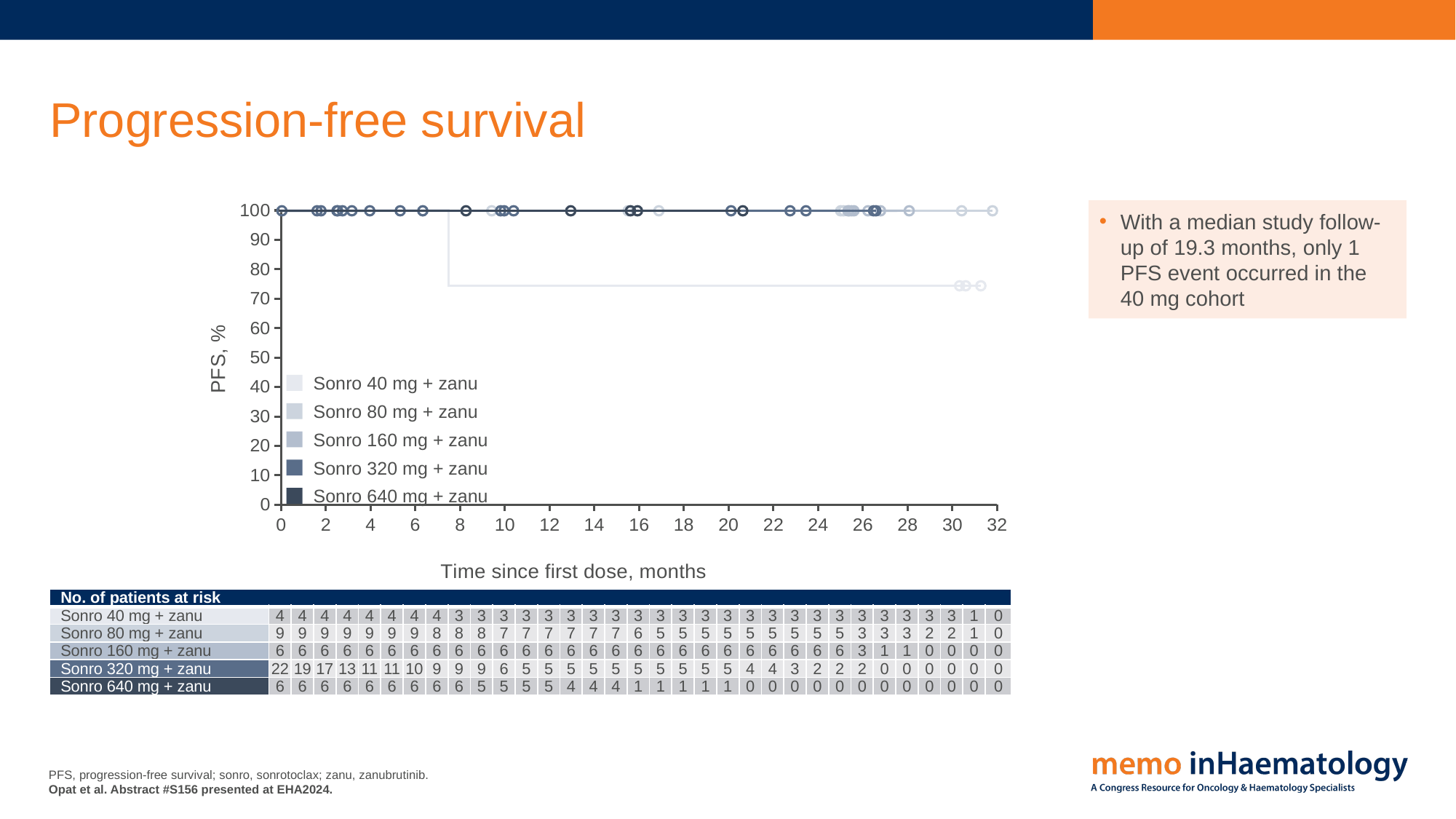
At time 0, which cohort had more patients at risk, Sonro 160 mg + zanu or Sonro 80 mg + zanu? Sonro 80 mg + zanu How many series does the legend list? 5 What is the difference in the number of patients at risk at time 0 between Sonro 320 mg + zanu and Sonro 80 mg + zanu? 13 In the number of patients at risk table, how many patients were at risk at time 0 for Sonro 80 mg + zanu? 9 What is the label of the y axis? PFS, % What is the label of the x axis? Time since first dose, months Is the PFS value for the Sonro 40 mg + zanu curve at 30 months greater or less than 80? less Which cohort had the most patients at risk at time 0? Sonro 320 mg + zanu Which cohort had the fewest patients at risk at time 0? Sonro 40 mg + zanu In the number of patients at risk table, how many patients were at risk at time 0 for Sonro 320 mg + zanu? 22 What kind of chart is shown on the slide? line chart Does the PFS curve for Sonro 640 mg + zanu fall or stay flat over time? stays flat at 100